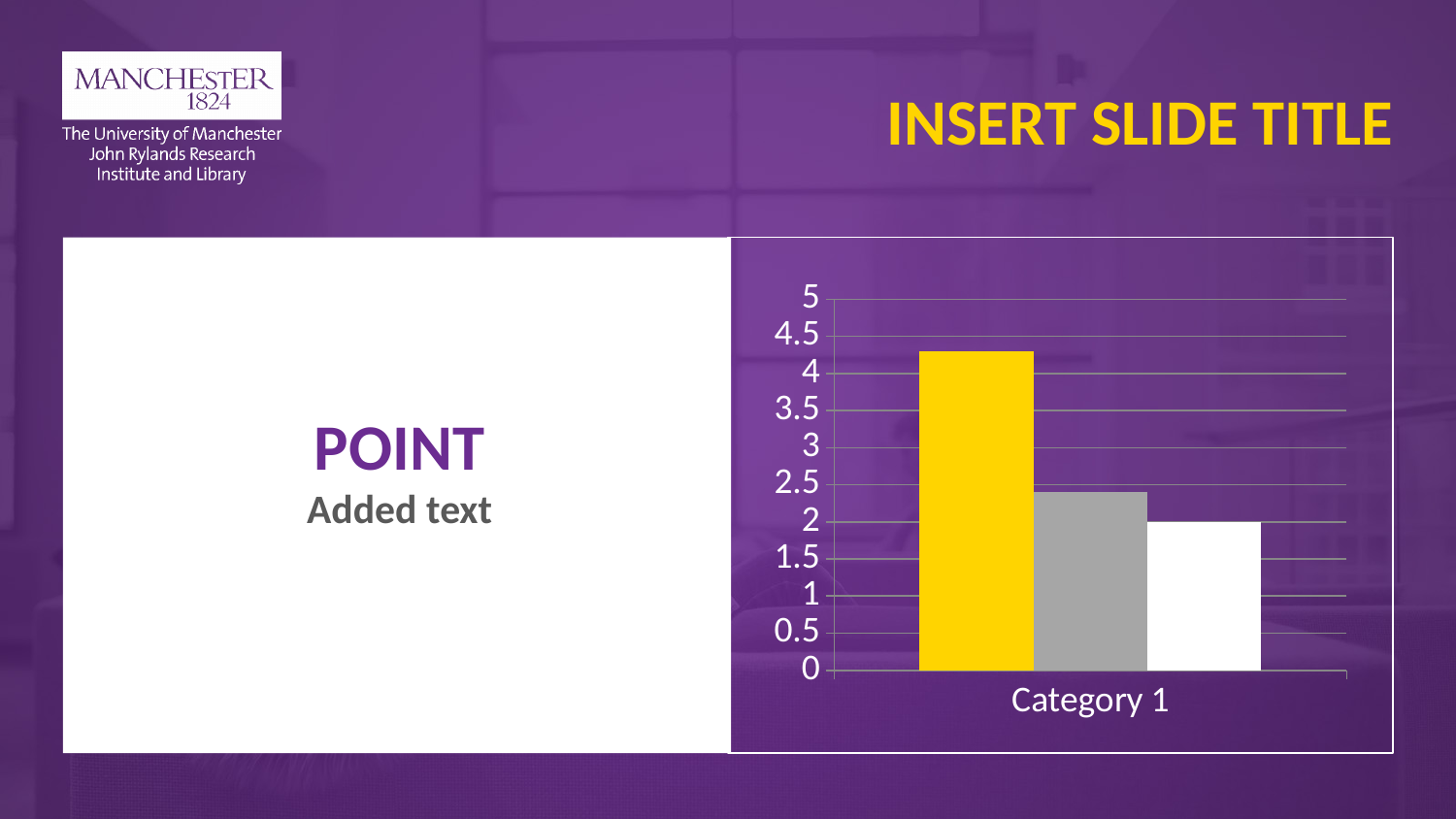
Is the value of the grey bar greater or less than 2? greater Is the value of the grey bar greater or less than 2.5? less Which bar is the shortest in the chart? the white bar Which bar is the tallest in the chart? the yellow bar How many categories are shown on the x axis of the chart? 1 Which is larger, the yellow bar or the grey bar? the yellow bar What is the label of the category on the x axis? Category 1 Is the value of the yellow bar greater or less than 4? greater What value does the white bar reach on the y axis? 2 How many bars are plotted in the chart? 3 What is the highest value shown on the y axis of the chart? 5 What kind of chart is shown on the slide? bar chart